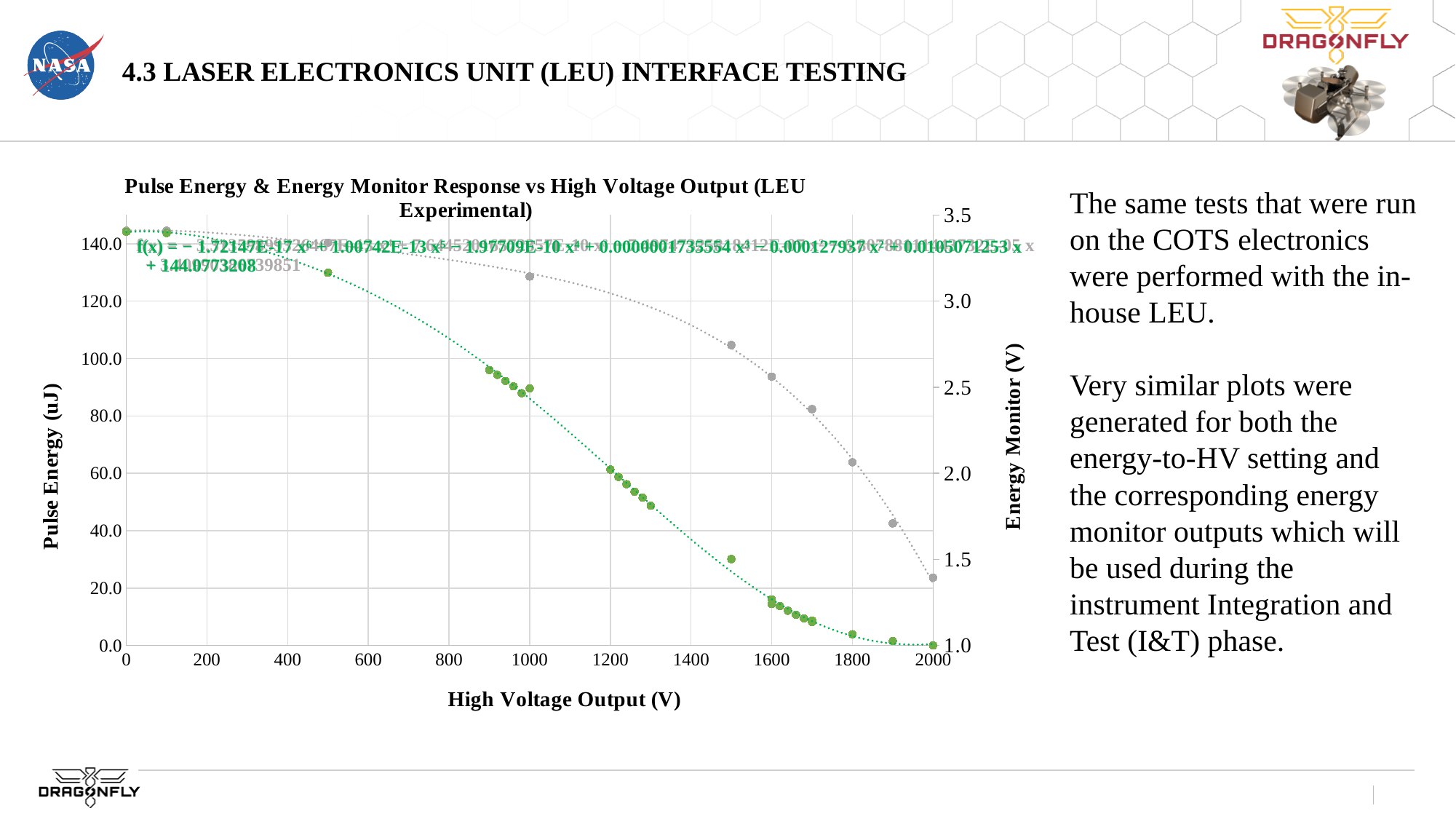
At which High Voltage Output value is the Pulse Energy lowest? 2000 V Is the Pulse Energy at a High Voltage Output of 500 V greater or less than 120? greater What is the title of the chart? Pulse Energy & Energy Monitor Response vs High Voltage Output (LEU Experimental) Is the Energy Monitor value at a High Voltage Output of 2000 V greater or less than 1.5? less As High Voltage Output increases along the x axis, does Pulse Energy rise or fall? fall Which has the larger Pulse Energy: a High Voltage Output of 500 V or 1500 V? 500 V What is the label of the x axis of the chart? High Voltage Output (V) What kind of chart is shown on the slide? scatter chart Is the Pulse Energy at a High Voltage Output of 1500 V greater or less than 40? less As High Voltage Output increases along the x axis, does the Energy Monitor value rise or fall? fall